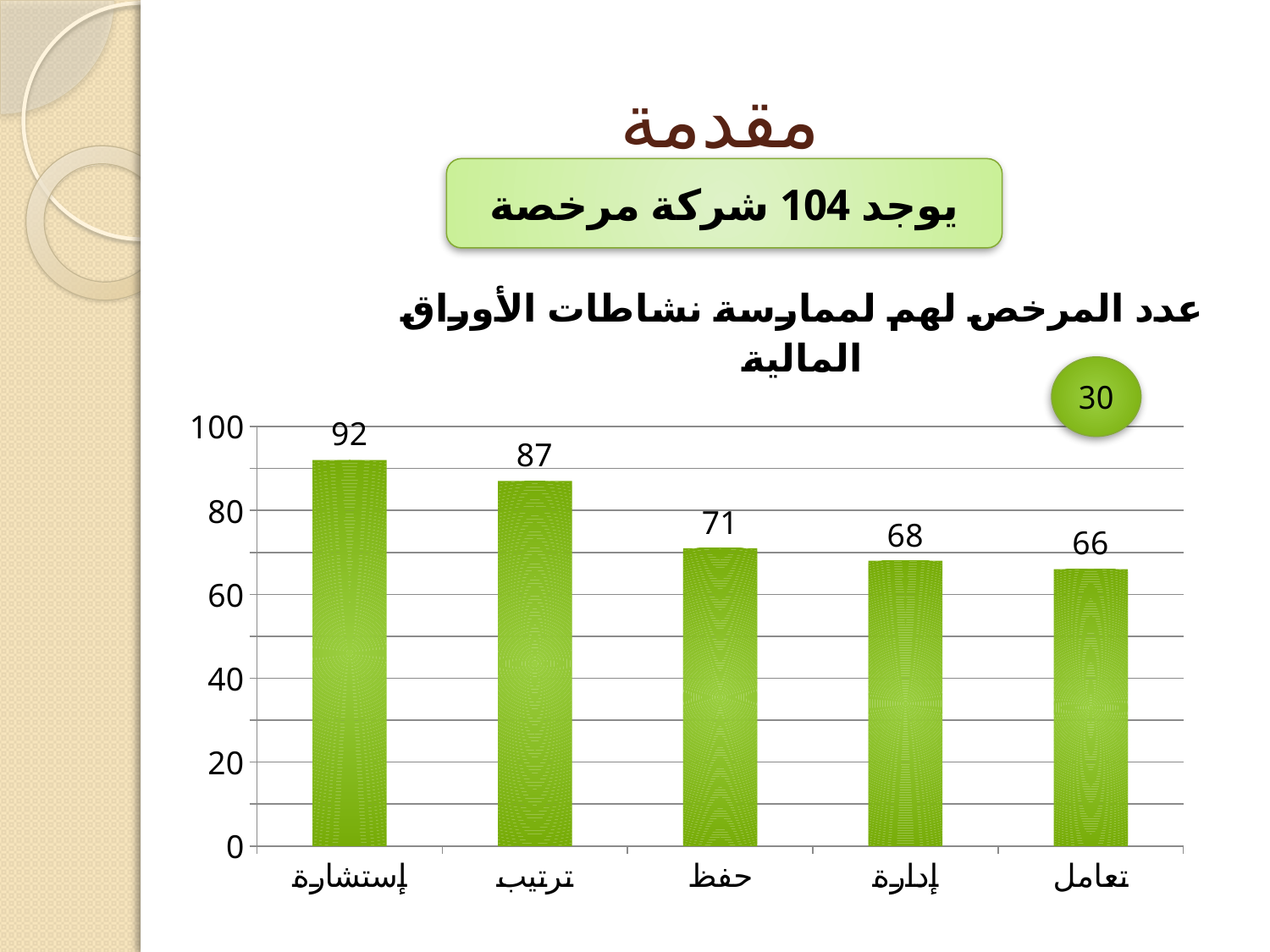
Which category has the lowest value? تعامل What is the value for تعامل? 66 What kind of chart is shown on the slide? bar chart What is the value for إستشارة? 92 What is the value for إدارة? 68 How many categories are shown in the chart? 5 What is the value for حفظ? 71 What is the difference between the values for حفظ and تعامل? 5 What is the difference between the values for إستشارة and ترتيب? 5 Do the values rise or fall from left to right along the x axis? fall Which category has the highest value? إستشارة Which is larger, the value for ترتيب or the value for حفظ? ترتيب